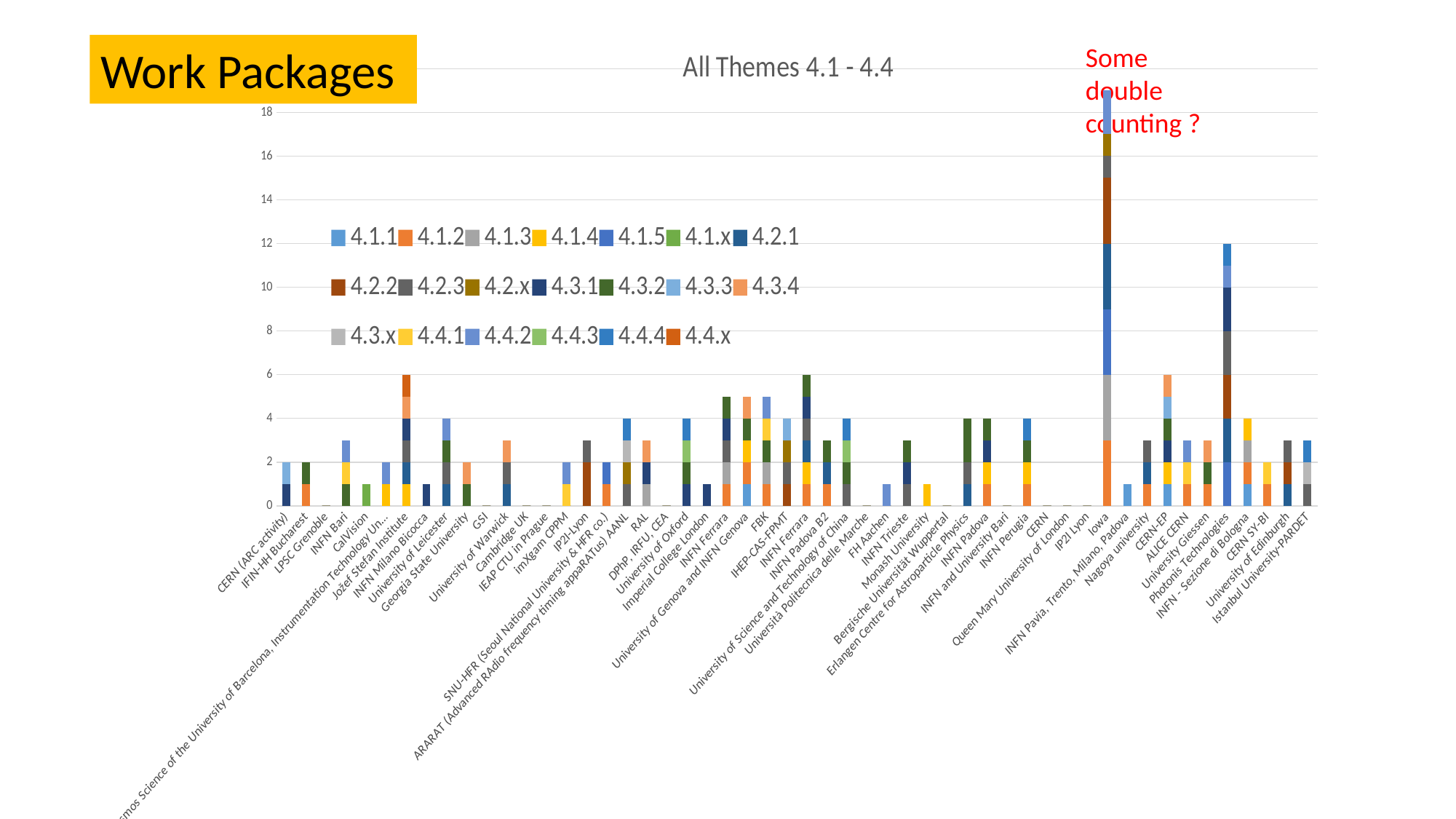
Is the total for Jožef Stefan Institute greater or less than 4? greater How many series does the chart legend list? 20 Is the total for CERN (ARC activity) greater or less than 4? less What does the red annotation text near the top right of the chart say? Some double counting ? Which has the larger total, Iowa or Photonis Technologies? Iowa What is the title of the chart? All Themes 4.1 - 4.4 Is the total for Photonis Technologies greater or less than 10? greater What kind of chart is shown on the slide? Stacked bar chart Which has the larger total, Photonis Technologies or INFN Ferrara? Photonis Technologies What is the total height of the stacked bar for Photonis Technologies? 12 Which institution has the tallest stacked bar? Iowa